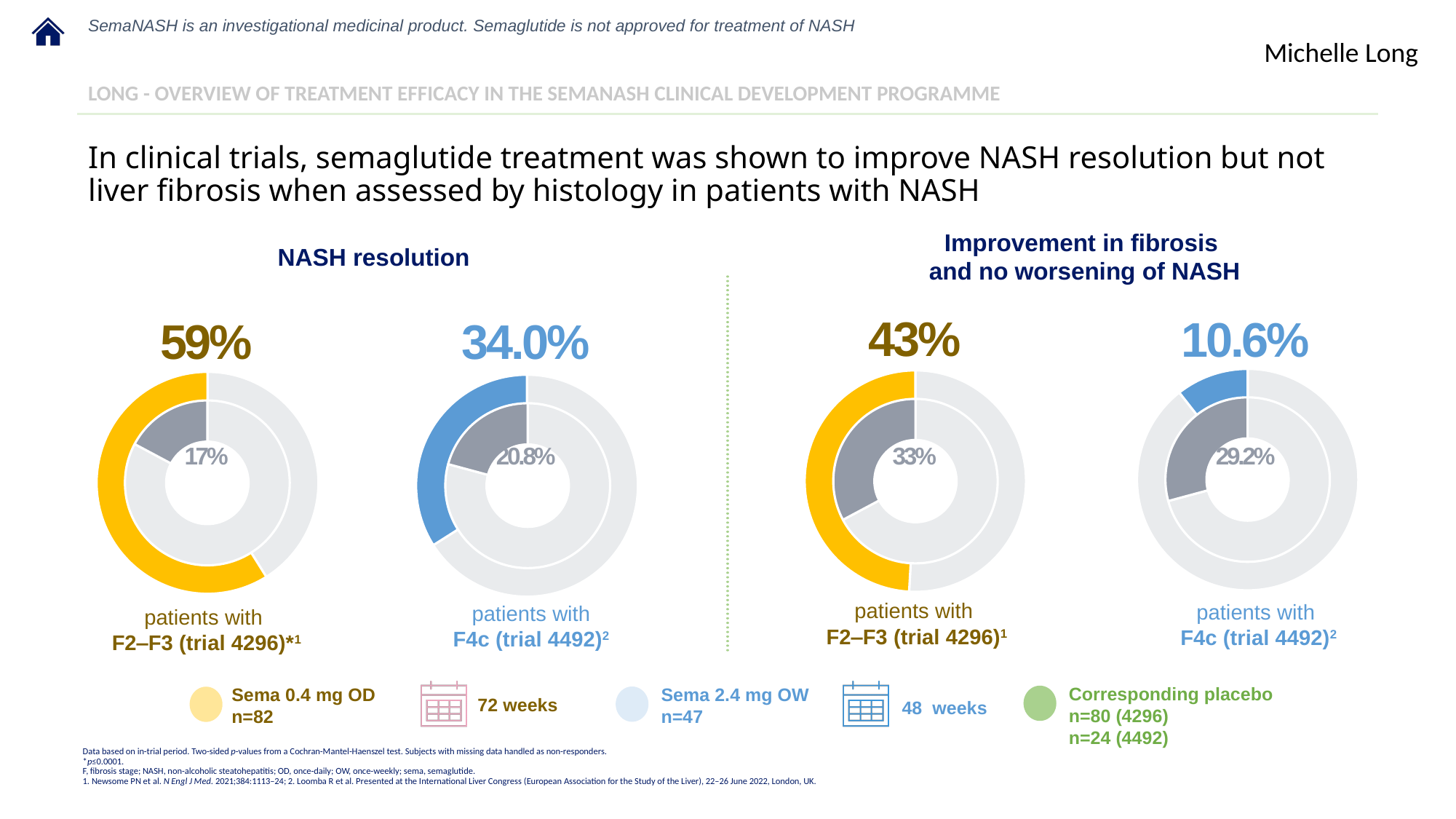
In the NASH resolution donut chart for patients with F2–F3 (trial 4296), what percentage is shown for the outer (semaglutide) ring? 59% Across the four donut charts, which outer-ring (semaglutide) value is the highest? 59% (NASH resolution, F2–F3, trial 4296) In the NASH resolution chart for patients with F2–F3 (trial 4296), what is the difference in percentage points between the semaglutide value and the placebo value? 42 percentage points In the 'Improvement in fibrosis and no worsening of NASH' donut chart for patients with F4c (trial 4492), what percentage is shown for the outer (semaglutide) ring? 10.6% In the 'Improvement in fibrosis and no worsening of NASH' chart for patients with F4c (trial 4492), which is larger: the semaglutide value or the placebo value? The placebo value (29.2%) In the NASH resolution donut chart for patients with F2–F3 (trial 4296), what percentage is shown for the inner (placebo) ring? 17% In the NASH resolution donut chart for patients with F4c (trial 4492), what percentage is shown for the outer (semaglutide) ring? 34.0% What kind of chart is used to display the results on this slide? Donut (pie) chart In the 'Improvement in fibrosis and no worsening of NASH' donut chart for patients with F4c (trial 4492), what percentage is shown for the inner (placebo) ring? 29.2% In the NASH resolution donut chart for patients with F4c (trial 4492), what percentage is shown for the inner (placebo) ring? 20.8% How many donut charts are shown on the slide? 4 In the 'Improvement in fibrosis and no worsening of NASH' donut chart for patients with F2–F3 (trial 4296), what percentage is shown for the outer (semaglutide) ring? 43%